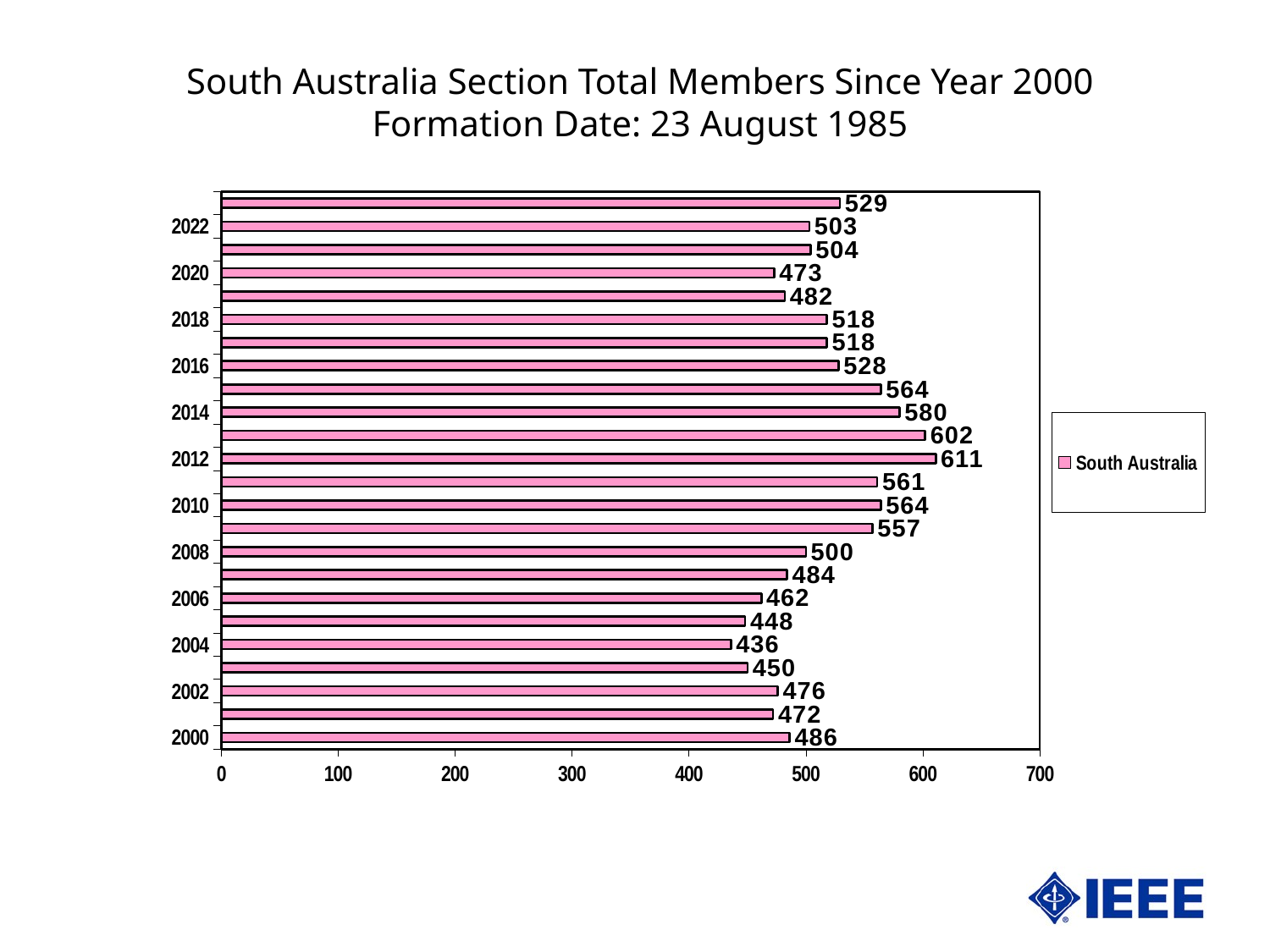
What series does the legend list? South Australia What is the value for 2000? 486 Is the value for 2010 greater or less than 500? greater What is the value for 2004? 436 Which is larger, the value for 2014 or the value for 2016? 2014 What is the value for 2020? 473 Which year has the highest value? 2012 What is the difference between the values for 2012 and 2004? 175 What is the value for 2012? 611 How many bars are plotted in the chart? 24 What kind of chart is shown? bar chart Which year has the lowest value? 2004